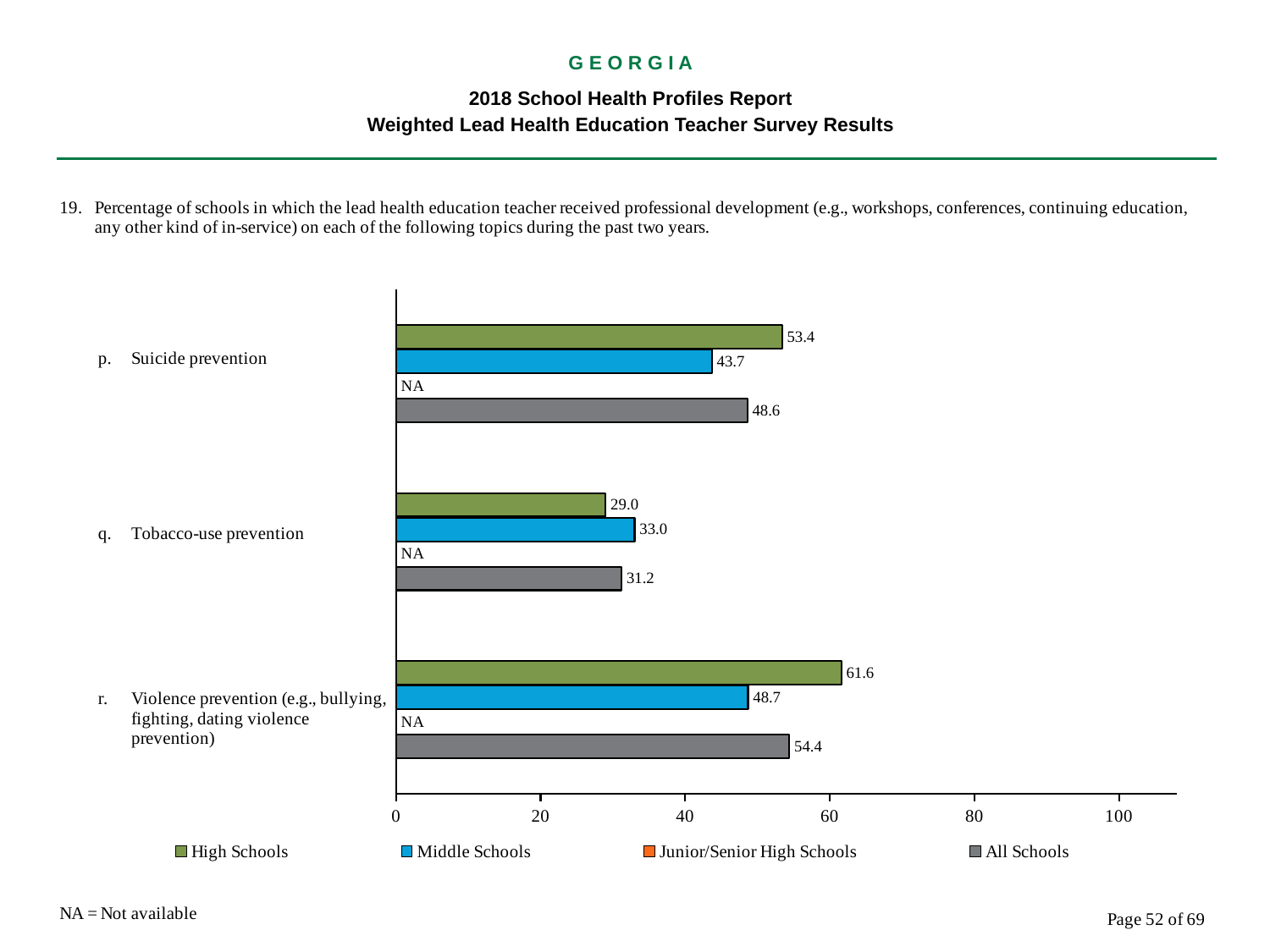
How many series does the legend list? 4 What kind of chart is this? Bar chart For Tobacco-use prevention, which is larger: the High Schools value or the Middle Schools value? Middle Schools Which topic has the lowest value for All Schools? Tobacco-use prevention What is the value for All Schools for Violence prevention? 54.4 Which topic has the highest value for High Schools? Violence prevention How many topics are shown on the chart? 3 What is shown for Junior/Senior High Schools for Suicide prevention? NA What is the value for Middle Schools for Tobacco-use prevention? 33.0 What colour represents All Schools in the legend? Gray What is the difference between the High Schools and Middle Schools values for Violence prevention? 12.9 What is the value for High Schools for Suicide prevention? 53.4